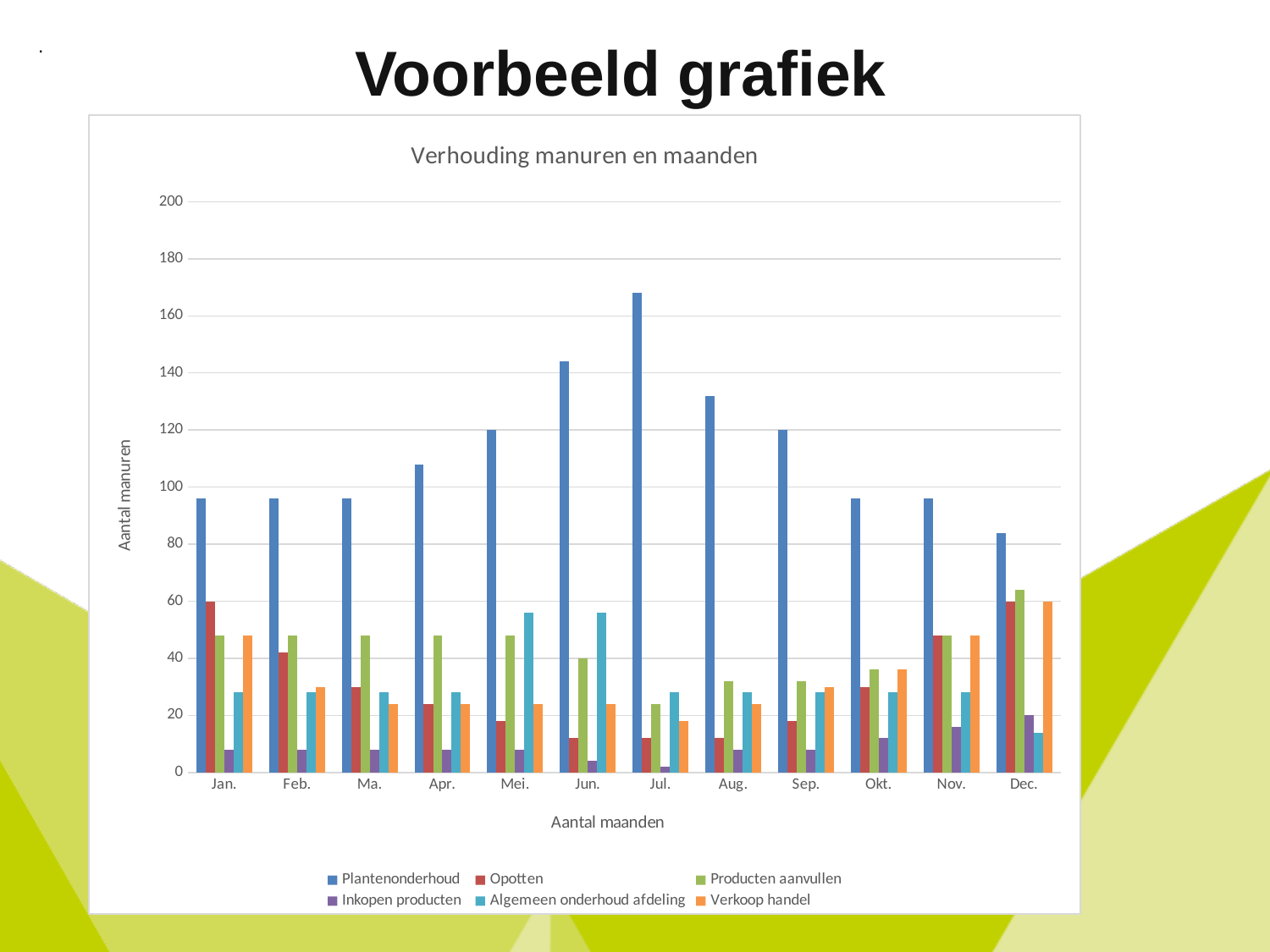
What is the label of the vertical axis? Aantal manuren What kind of chart is shown on the slide? bar chart How many months are shown on the x axis? 12 In which month is the Plantenonderhoud value highest? Jul. Which is larger, the Plantenonderhoud value for Jun. or for Aug.? Jun. What is the Plantenonderhoud value for Mei.? 120 What is the title of the chart? Verhouding manuren en maanden Is the Plantenonderhoud value for Jul. greater or less than 160? greater In which month is the Inkopen producten value lowest? Jul. How many series does the legend list? 6 Is the Plantenonderhoud value for Jan. greater or less than 100? less Is the Algemeen onderhoud afdeling value for Jun. greater or less than 40? greater